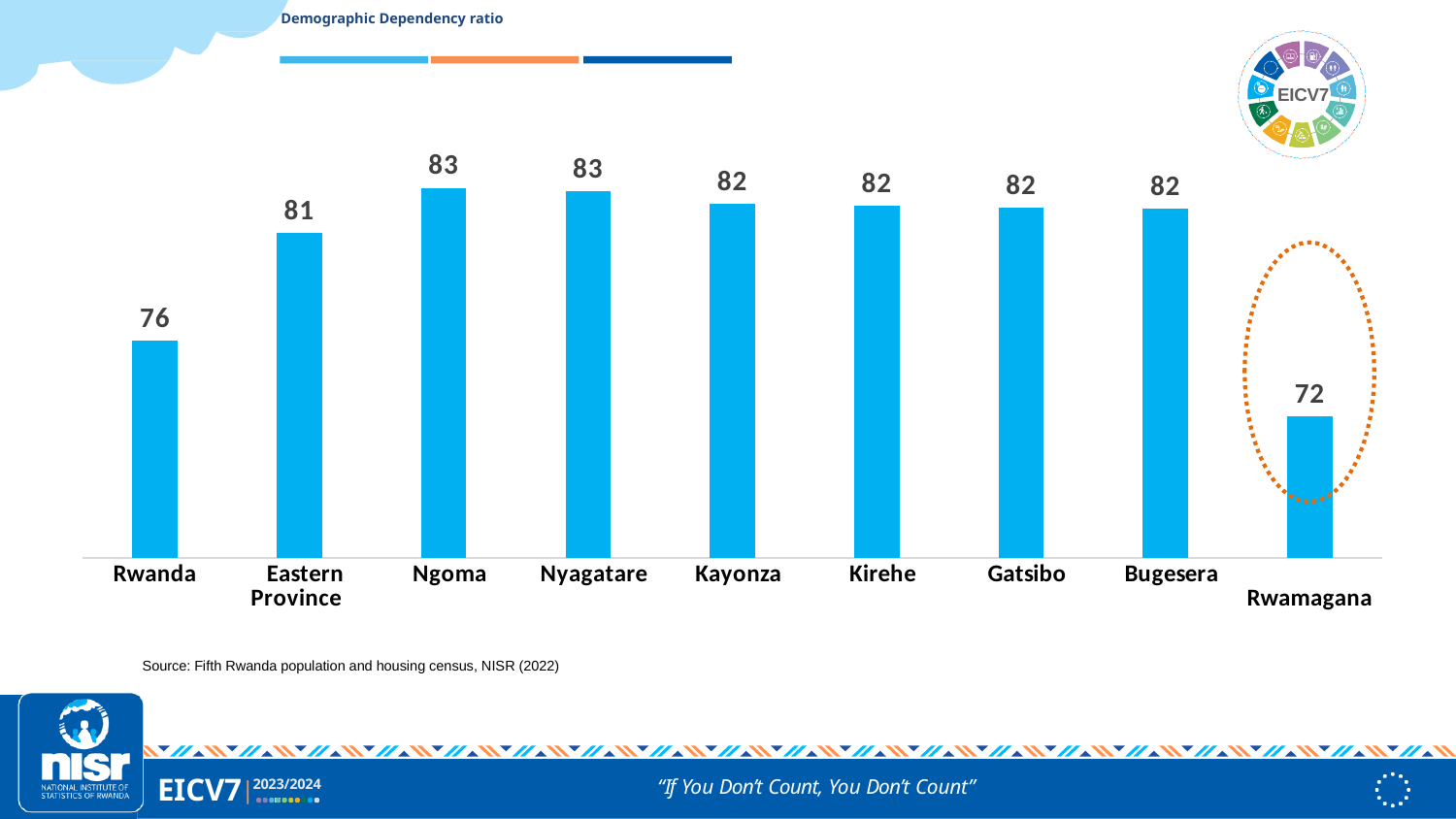
Which has a higher demographic dependency ratio, Rwanda or Bugesera? Bugesera What is the demographic dependency ratio for Rwamagana? 72 What kind of chart is shown on the slide? Bar chart What is the demographic dependency ratio for Rwanda? 76 Which category has the lowest demographic dependency ratio? Rwamagana Which has a higher demographic dependency ratio, Nyagatare or Kayonza? Nyagatare What is the demographic dependency ratio for Eastern Province? 81 What is the difference between the demographic dependency ratio of Eastern Province and Rwanda? 5 How many categories are shown in the chart? 9 What is the difference between the demographic dependency ratio of Ngoma and Rwamagana? 11 What is the title of the chart? Demographic Dependency ratio What is the demographic dependency ratio for Kirehe? 82